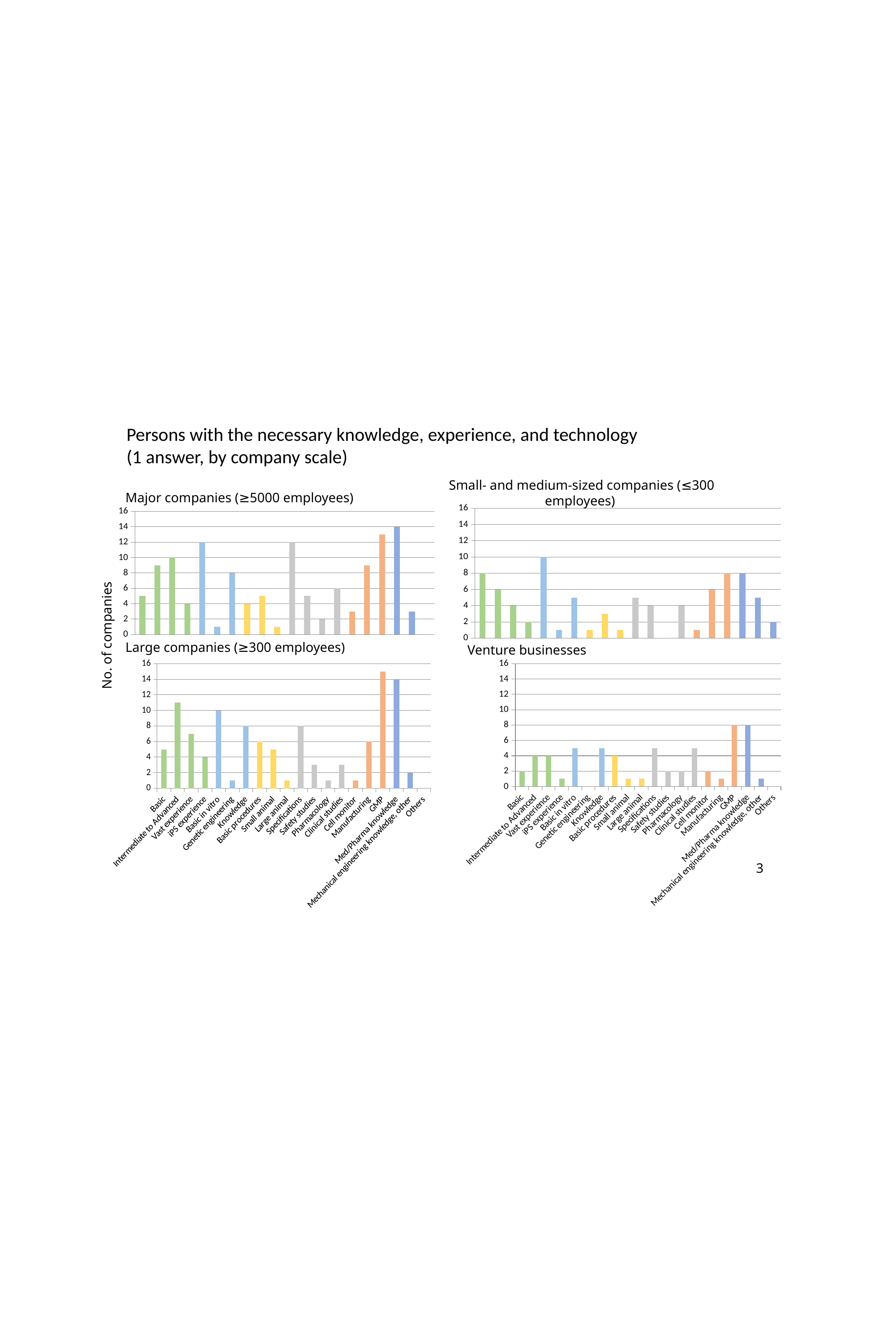
In the Small- and medium-sized companies (≤300 employees) chart, which category has the highest value? Basic in vitro In the Large companies (≥300 employees) chart, what is the value for Basic in vitro? 10 In the Major companies (≥5000 employees) chart, which is larger, Basic in vitro or Knowledge? Basic in vitro In the Major companies (≥5000 employees) chart, what is the difference between Med/Pharma knowledge and Basic in vitro? 2 In the Major companies (≥5000 employees) chart, what is the value for Med/Pharma knowledge? 14 In the Large companies (≥300 employees) chart, is the value for Intermediate to Advanced greater or less than 10? greater In the Major companies (≥5000 employees) chart, is the value for GMP greater or less than 12? greater In the Large companies (≥300 employees) chart, which category has the highest value? GMP In the Venture businesses chart, what is the value for GMP? 8 In the Small- and medium-sized companies (≤300 employees) chart, what is the value for Basic? 8 In the Major companies (≥5000 employees) chart, what is the value for Basic in vitro? 12 What kind of chart is the Venture businesses chart? bar chart